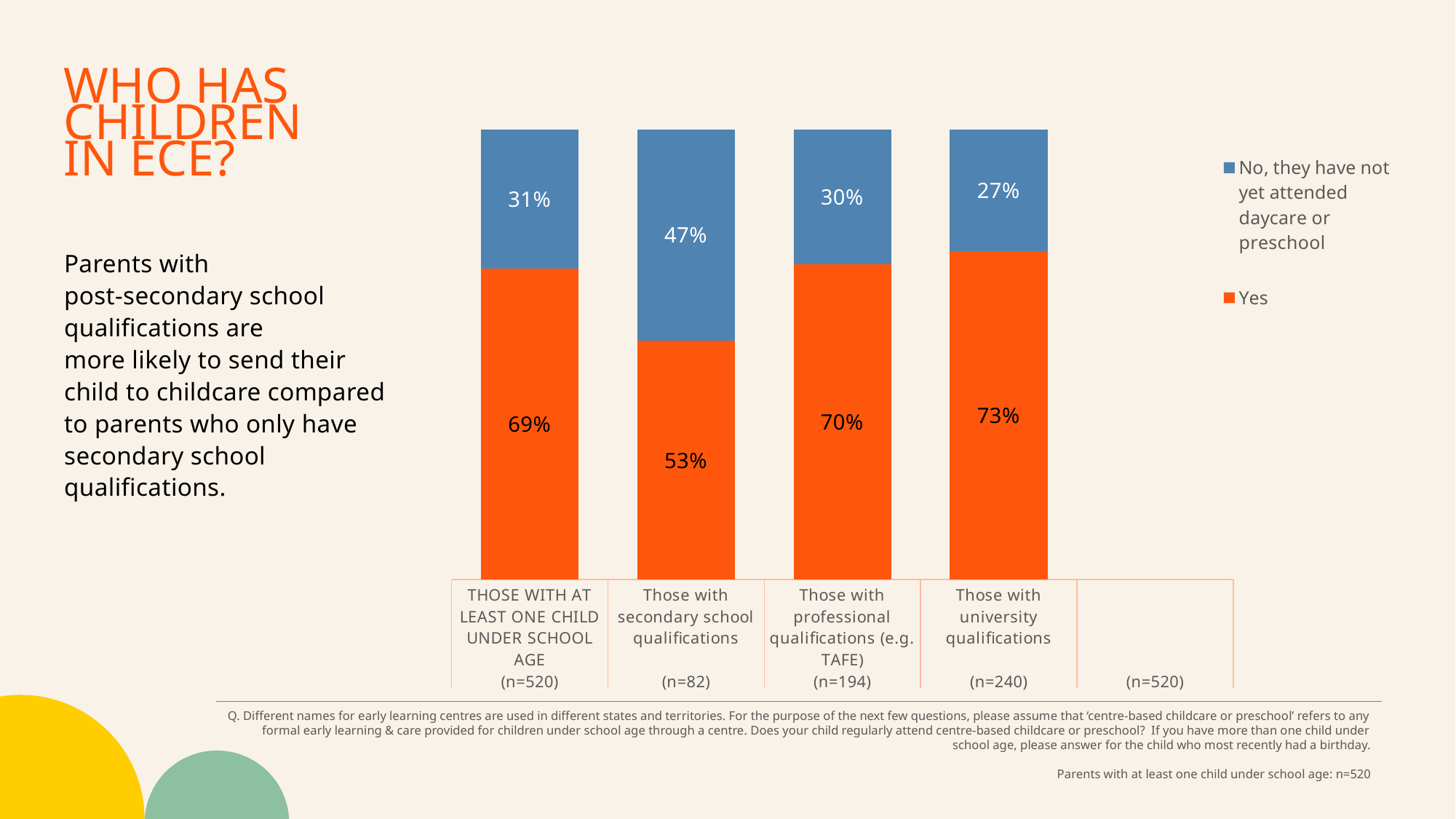
Which is larger: the "No" value for those with secondary school qualifications or for those with professional qualifications (e.g. TAFE)? Those with secondary school qualifications Which category has the highest "Yes" value? Those with university qualifications What percentage of those with secondary school qualifications answered "Yes"? 53% What is the "No, they have not yet attended daycare or preschool" value for those with university qualifications? 27% What is the "No, they have not yet attended daycare or preschool" value for those with at least one child under school age? 31% What is the total of the stacked bar for those with professional qualifications (e.g. TAFE)? 100% Which colour represents the "Yes" series? Orange What is the "Yes" value for those with professional qualifications (e.g. TAFE)? 70% What kind of chart is shown on the slide? Stacked bar chart How many series does the legend list? 2 Which category has the lowest "Yes" value? Those with secondary school qualifications What is the difference between the "Yes" values for those with university qualifications and those with secondary school qualifications? 20%